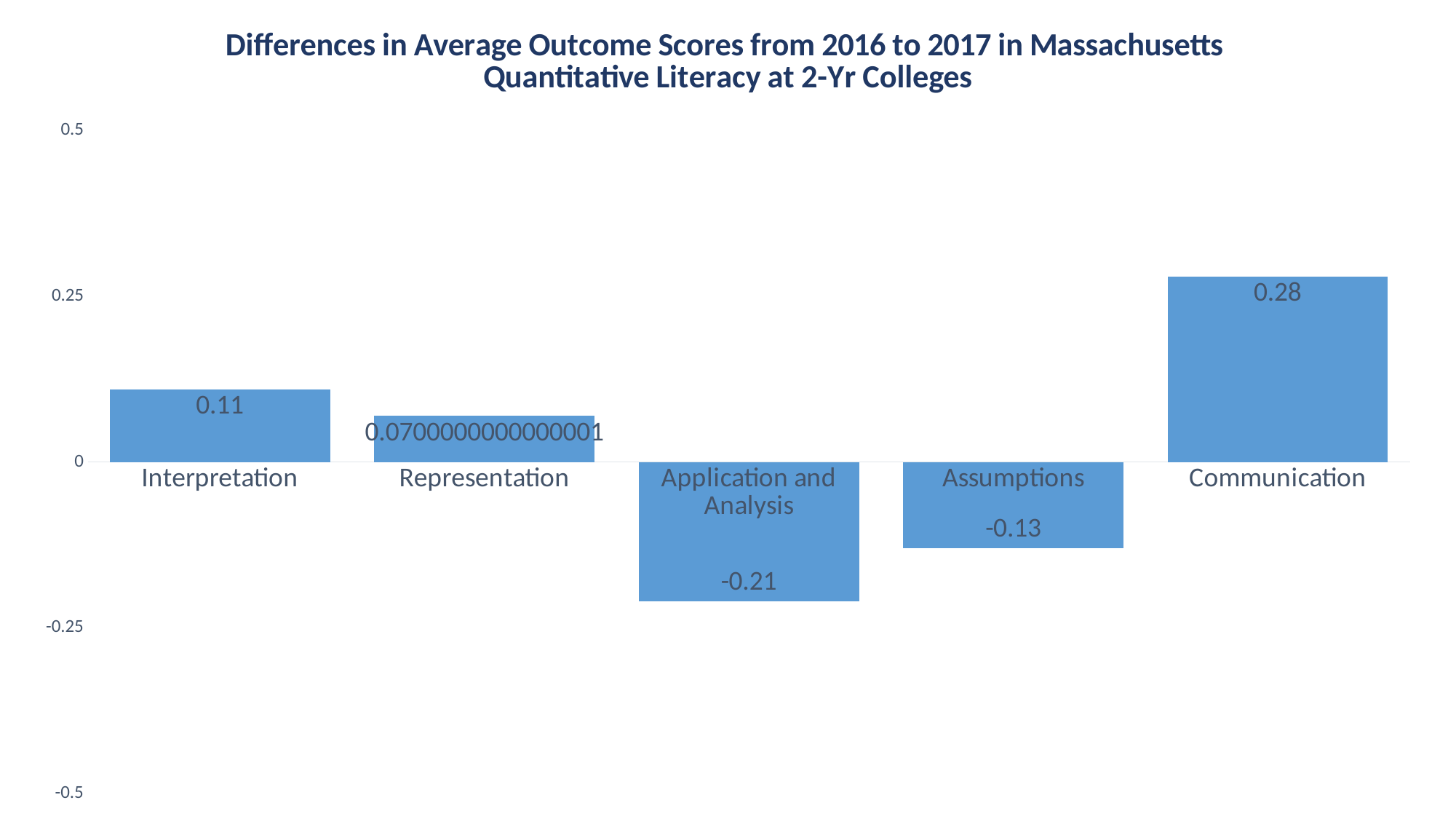
What kind of chart is this? Bar chart What is the title of the chart? Differences in Average Outcome Scores from 2016 to 2017 in Massachusetts Quantitative Literacy at 2-Yr Colleges What is the difference between the values for Communication and Interpretation? 0.17 Which is larger, the value for Interpretation or the value for Assumptions? Interpretation What is the value for Communication? 0.28 What is the value for Assumptions? -0.13 Which category has the highest value? Communication How many categories are shown in the chart? 5 What is the value for Application and Analysis? -0.21 Is the value for Communication greater or less than 0.25? greater Which category has the lowest value? Application and Analysis What is the value for Interpretation? 0.11